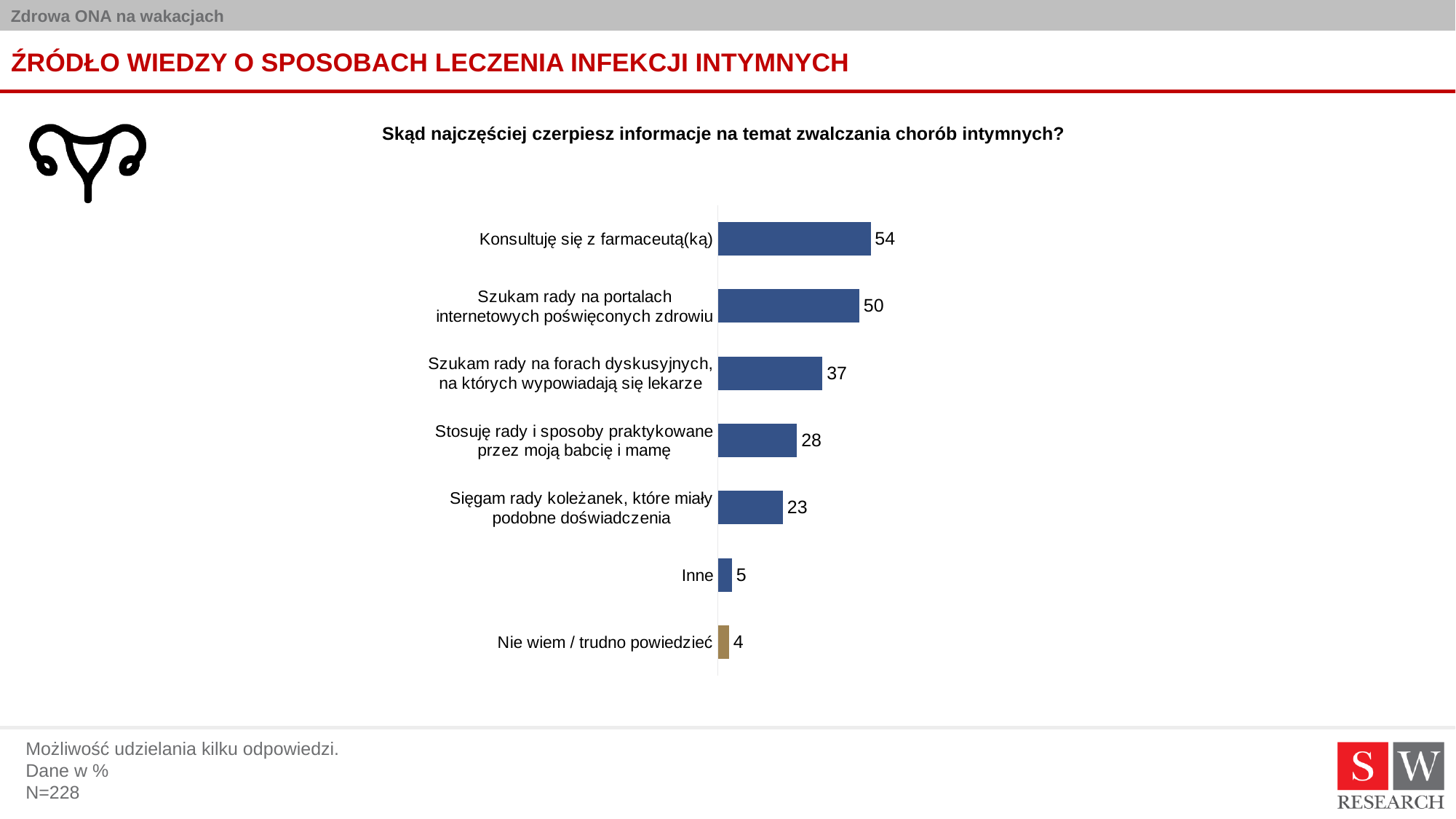
How many categories are shown in the chart? 7 Which category has the lowest value? Nie wiem / trudno powiedzieć What kind of chart is shown on the slide? Bar chart What is the value for "Szukam rady na forach dyskusyjnych, na których wypowiadają się lekarze"? 37 Which category has the highest value? Konsultuję się z farmaceutą(ką) Which is larger: the value for "Szukam rady na forach dyskusyjnych, na których wypowiadają się lekarze" or for "Stosuję rady i sposoby praktykowane przez moją babcię i mamę"? Szukam rady na forach dyskusyjnych, na których wypowiadają się lekarze What is the difference between the values for "Konsultuję się z farmaceutą(ką)" and "Szukam rady na portalach internetowych poświęconych zdrowiu"? 4 What is the value for "Inne"? 5 What is the value for "Konsultuję się z farmaceutą(ką)"? 54 Which category's bar is shown in a different colour from the others? Nie wiem / trudno powiedzieć What question is the chart titled with? Skąd najczęściej czerpiesz informacje na temat zwalczania chorób intymnych? What is the difference between the values for "Stosuję rady i sposoby praktykowane przez moją babcię i mamę" and "Sięgam rady koleżanek, które miały podobne doświadczenia"? 5